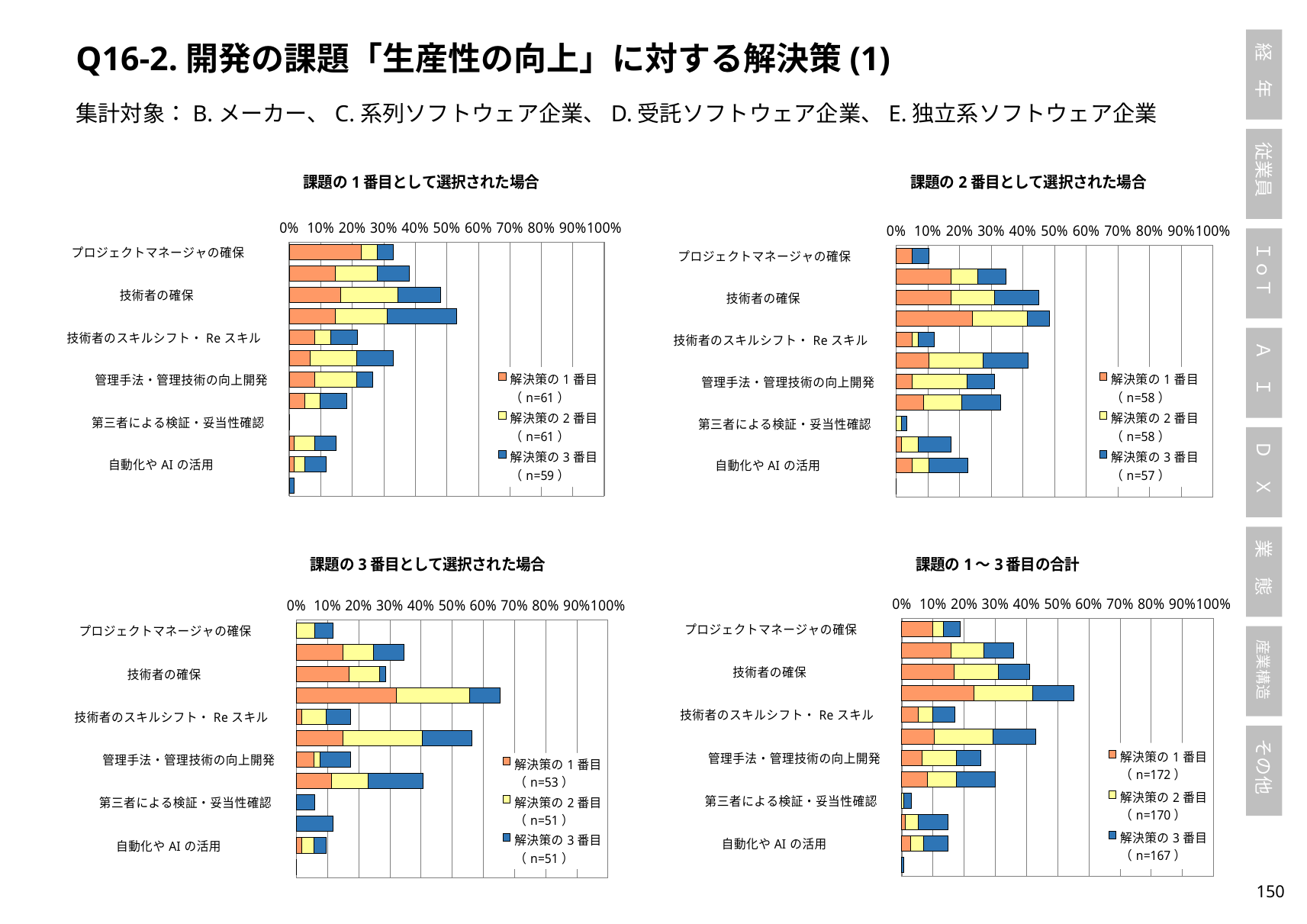
In the chart titled 課題の1～3番目の合計, is the total of the topmost bar greater or less than 30%? less How many charts are shown on the slide? 4 In the chart titled 課題の1番目として選択された場合, is the total of the topmost bar greater or less than 20%? greater In the chart titled 課題の3番目として選択された場合, is the total of the longest stacked bar greater or less than 60%? greater What is the maximum value shown on the horizontal axis of the chart titled 課題の2番目として選択された場合? 100% In the chart titled 課題の1番目として選択された場合, how many series does the legend list? 3 In the chart titled 課題の1～3番目の合計, what n value is shown in the legend for 解決策の1番目? n=172 In the chart titled 課題の3番目として選択された場合, what n value is shown in the legend for 解決策の3番目? n=51 In the chart titled 課題の1～3番目の合計, how many series does the legend list? 3 What kind of chart is used in the four charts on this slide? bar chart How many category labels are listed on the vertical axis of the chart titled 課題の1番目として選択された場合? 6